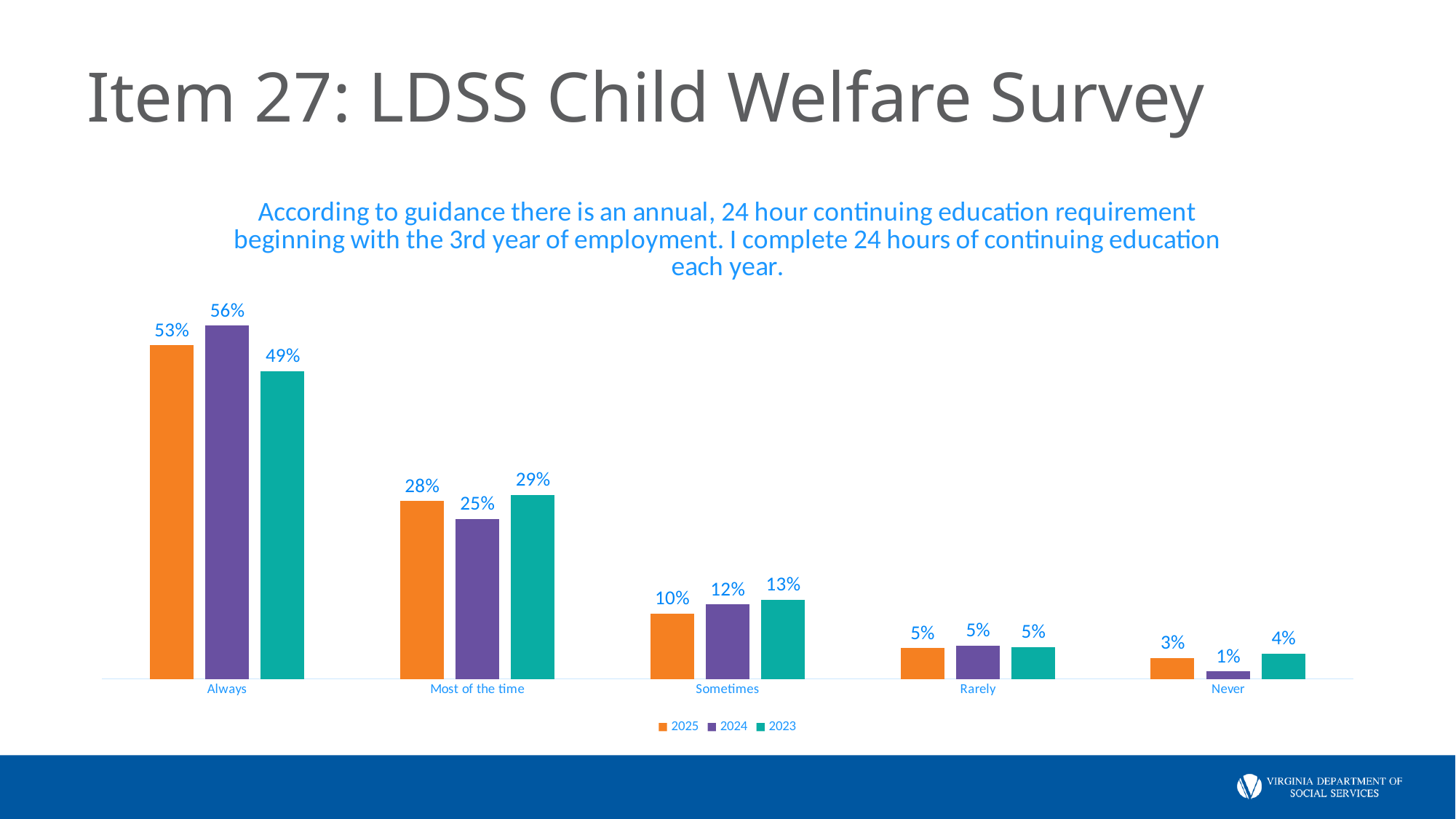
How many categories are shown on the x axis? 5 Which category has the highest value for the 2024 series? Always What is the value for 2024 in the Never category? 1% What is the value for 2025 in the Always category? 53% In the Sometimes category, which is larger, the 2025 value or the 2023 value? 2023 Which series is shown in orange in the legend? 2025 How many series does the legend list? 3 What kind of chart is shown on the slide? Bar chart Which category has the lowest value for the 2025 series? Never What is the difference between the 2024 and 2023 values in the Always category? 7% Do the values for the 2023 series rise or fall from Always to Never along the x axis? Fall What is the value for 2023 in the Most of the time category? 29%